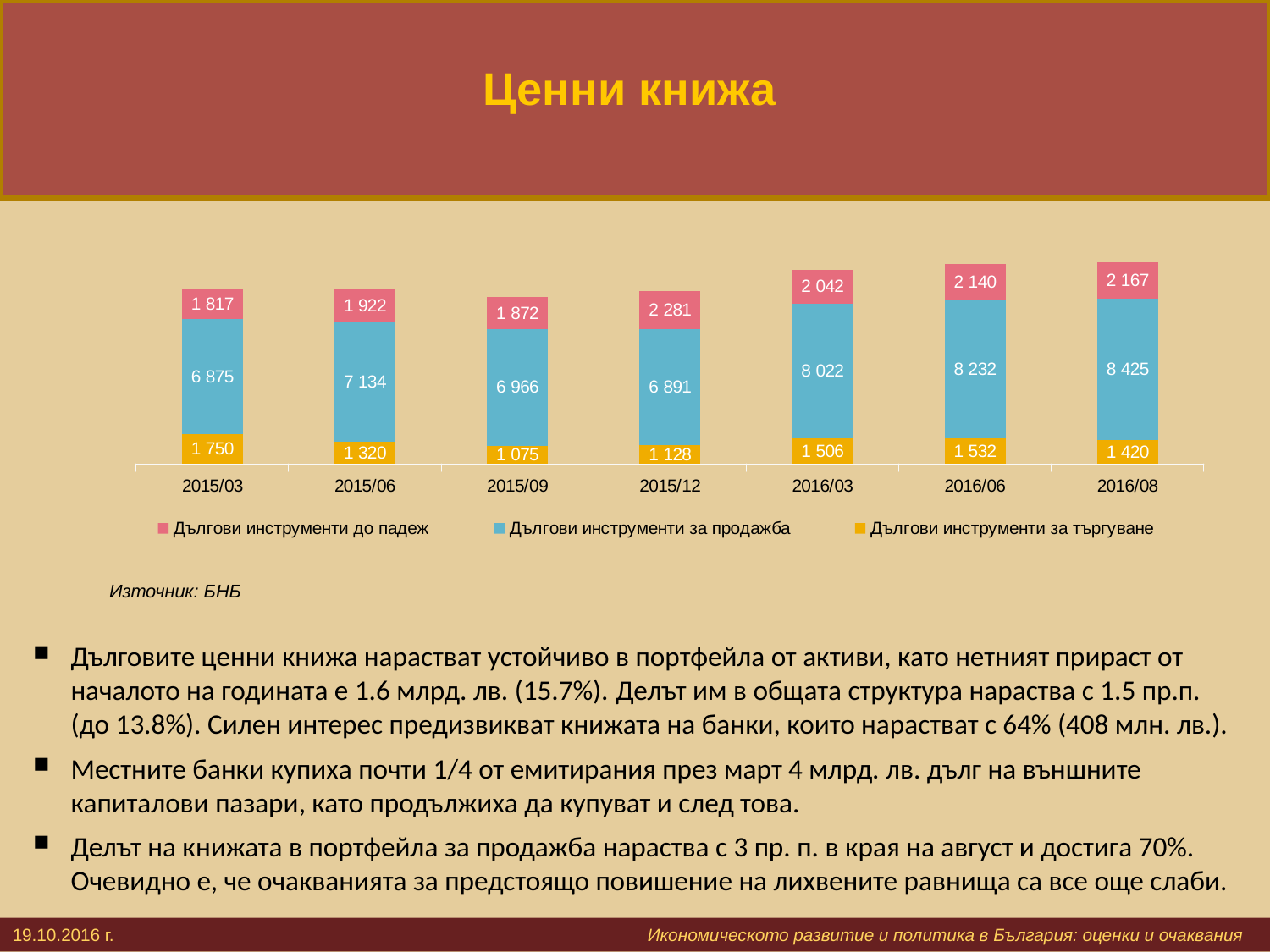
How many series does the legend list? 3 What kind of chart is shown on the slide? Stacked bar chart What is the total of the stacked bar for 2016/08? 12 012 What is the value of Дългови инструменти до падеж for 2015/12? 2 281 How many periods are shown on the x axis? 7 What is the value of Дългови инструменти за търгуване for 2015/09? 1 075 In which period is Дългови инструменти за продажба the lowest? 2015/03 What is the value of Дългови инструменти за продажба for 2016/08? 8 425 Which is larger: Дългови инструменти до падеж in 2015/12 or in 2016/03? 2015/12 What is the difference between Дългови инструменти за продажба in 2016/08 and in 2016/06? 193 What is the source cited below the chart? БНБ In which period is Дългови инструменти за търгуване the highest? 2015/03